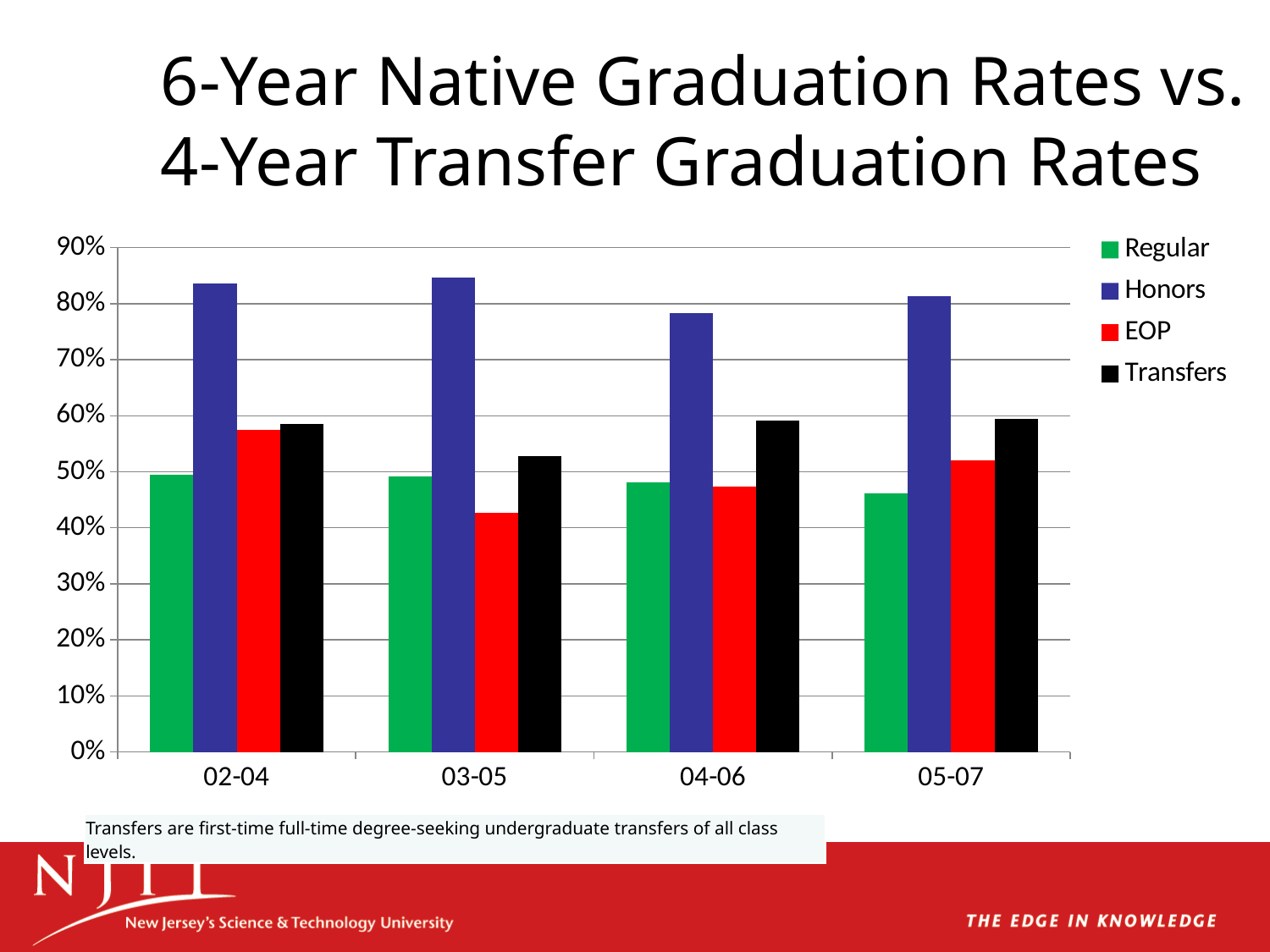
In which period is the EOP value lowest? 03-05 In the 02-04 period, which is larger: Regular or EOP? EOP What kind of chart is shown on the slide? bar chart Is the Transfers value for 04-06 greater or less than 50%? greater How many series does the legend list? 4 Is the Honors value for 02-04 greater or less than 80%? greater Which series has the highest value in the 02-04 period? Honors Is the Regular value for 05-07 greater or less than 50%? less In the 03-05 period, which is larger: EOP or Transfers? Transfers How many cohort periods are shown on the x axis? 4 Which colour represents the Transfers series in the legend? black